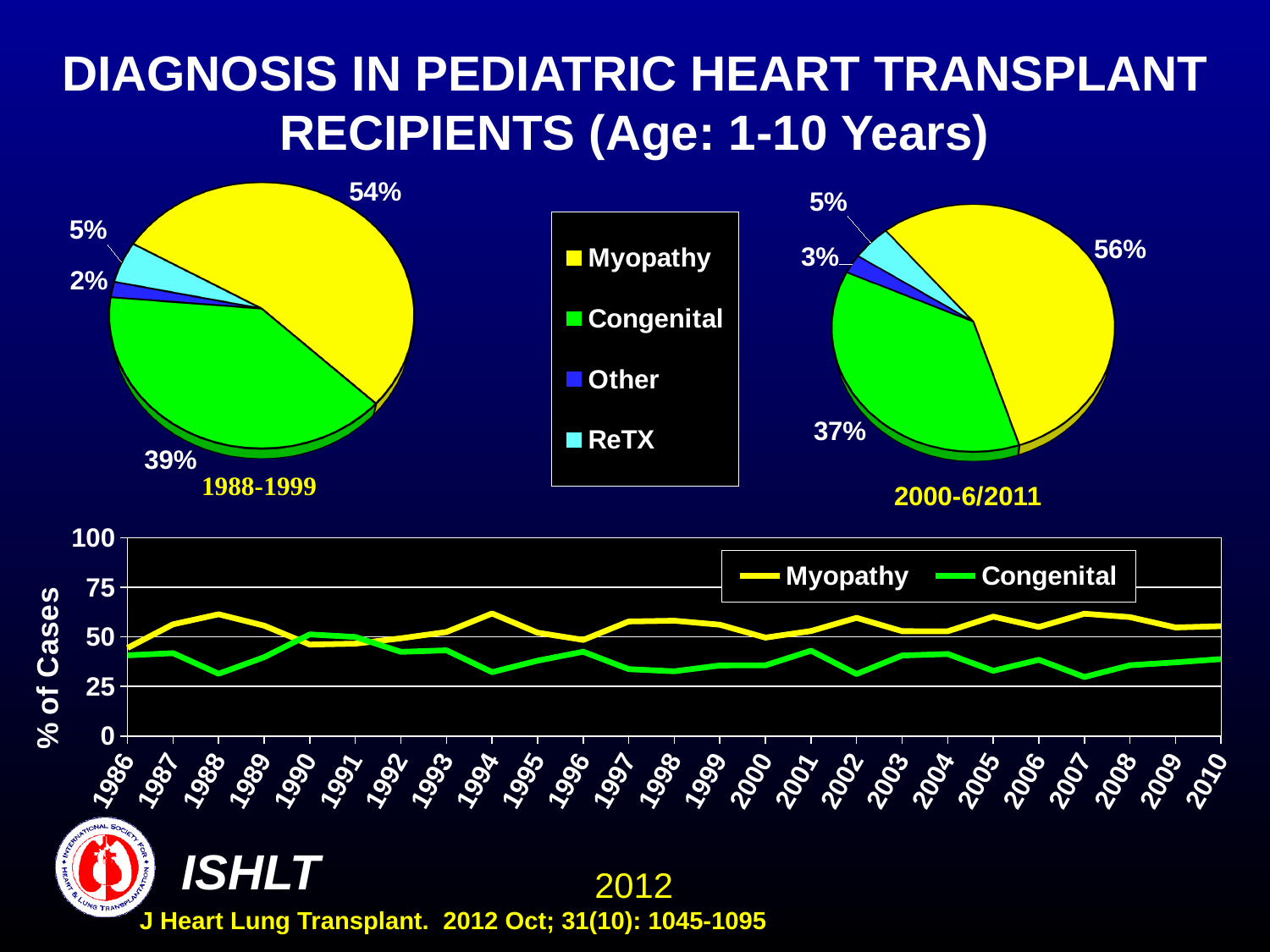
Comparing the two pie charts, is the Myopathy share larger in 1988-1999 or in 2000-6/2011? 2000-6/2011 How many series does the legend of the bottom line chart list? 2 How many categories does the pie chart legend list? 4 What type of chart is the bottom chart on the slide? Line chart In the 2000-6/2011 pie chart, what share of cases is Myopathy? 56% In the 2000-6/2011 pie chart, which diagnosis has the largest share? Myopathy In the bottom line chart, is the value for Congenital in 1988 greater or less than 50? less In the 2000-6/2011 pie chart, what share of cases is Other? 3% In the 1988-1999 pie chart, what share of cases is Myopathy? 54% In the 2000-6/2011 pie chart, what is the difference between the Myopathy and Congenital shares? 19% In the 1988-1999 pie chart, what share of cases is Congenital? 39% In the 1988-1999 pie chart, which diagnosis has the smallest share? Other